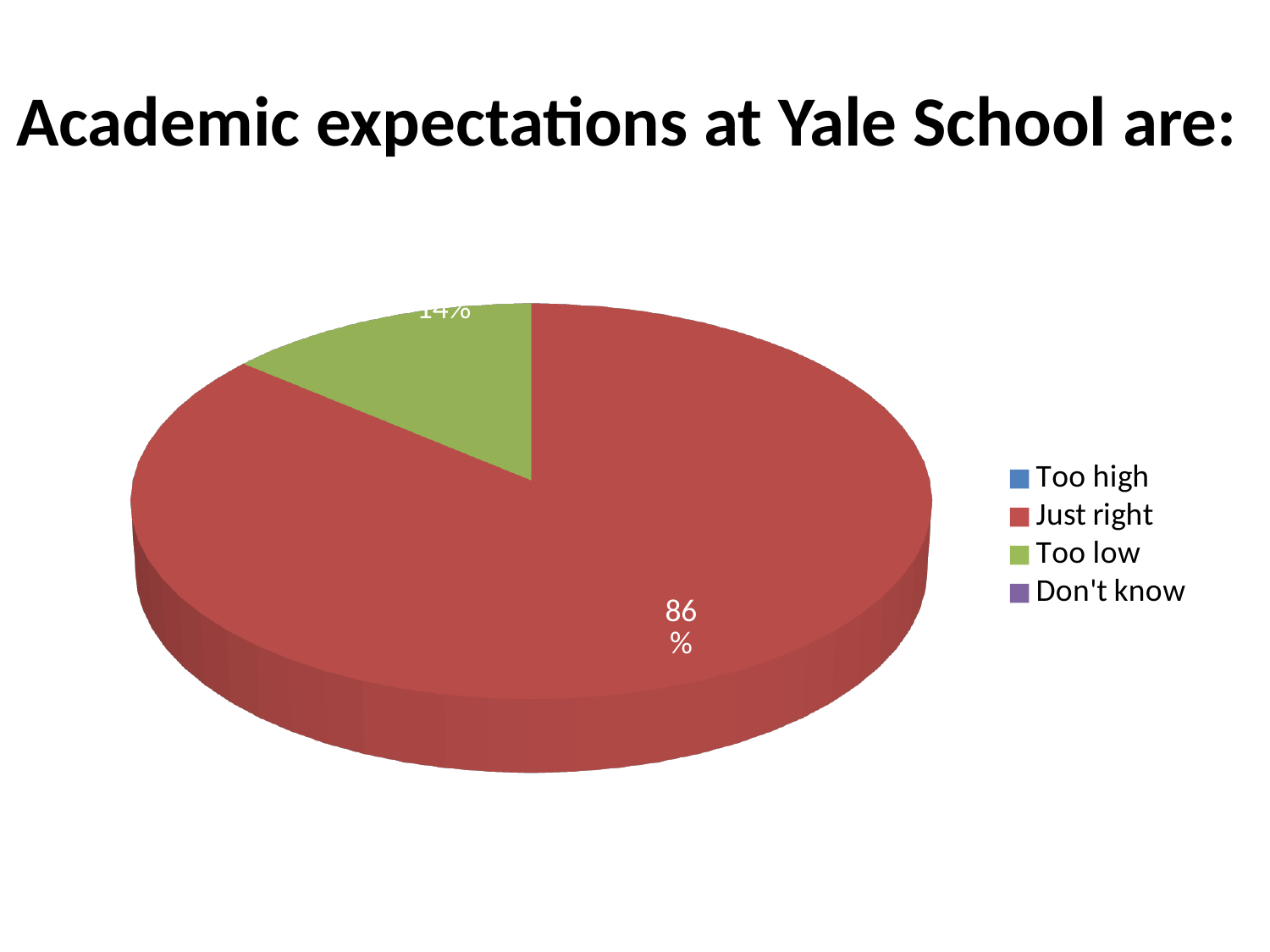
By how many percentage points does "Just right" exceed "Too low"? 72 What percentage of respondents said academic expectations are "Just right"? 86% Which category has the largest slice of the pie? Just right What kind of chart is shown on the slide? pie chart How many categories does the legend list? 4 What is the title of the chart? Academic expectations at Yale School are: What share of the pie does the "Too low" slice represent? 14% What percentage of respondents said academic expectations are "Too low"? 14% Which is larger, the share for "Just right" or the share for "Too low"? Just right What colour is the "Just right" slice? red Of the two slices visible in the pie, which is smaller? Too low